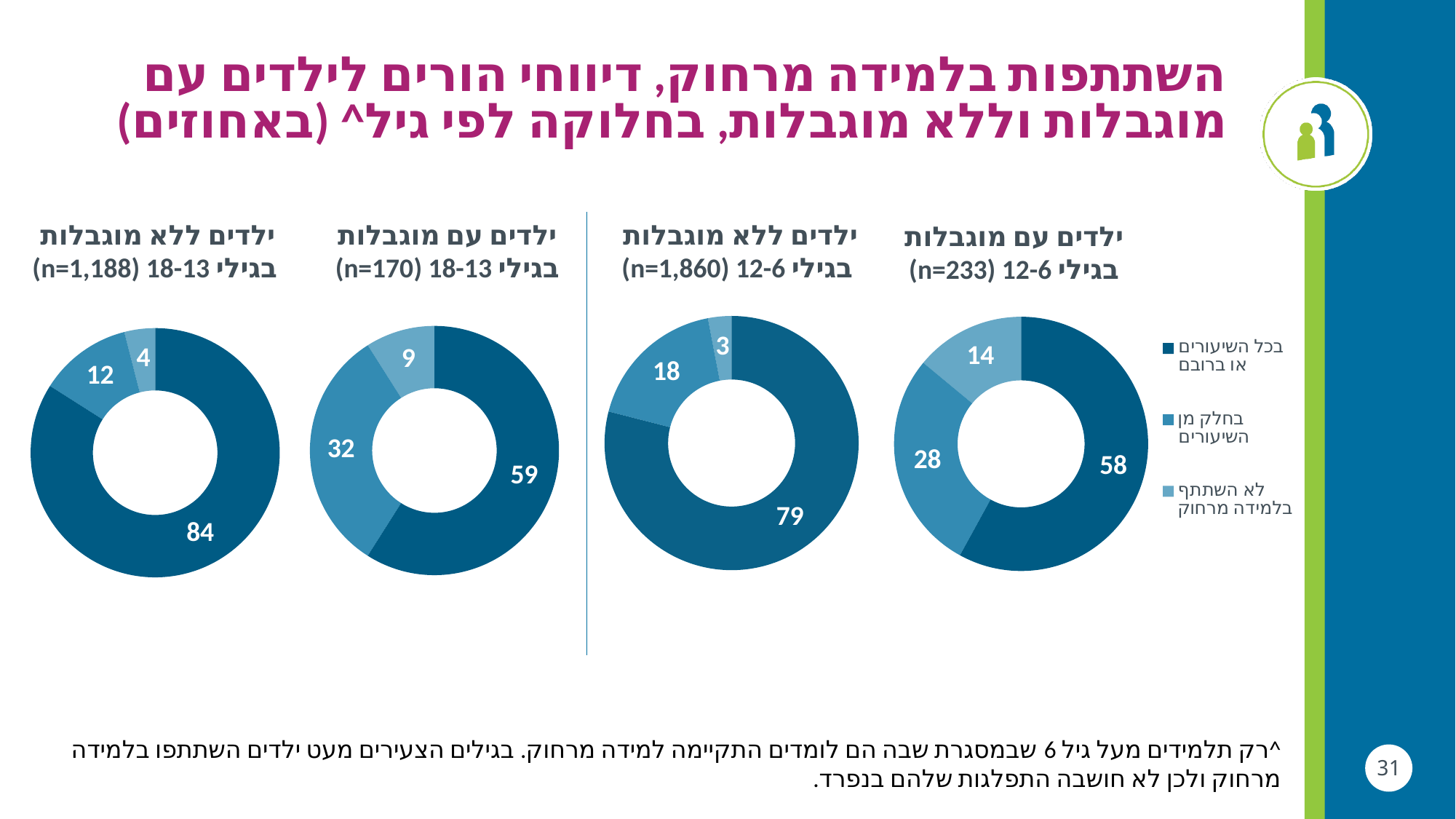
In the chart titled 'ילדים עם מוגבלות בגילי 6-12 (n=233)', what is the value for 'בכל השיעורים או ברובם'? 58 What kind of chart is used on this slide? Donut chart In the chart titled 'ילדים עם מוגבלות בגילי 6-12 (n=233)', which category has the smallest value? לא השתתף בלמידה מרחוק In the chart titled 'ילדים ללא מוגבלות בגילי 13-18 (n=1,188)', which category has the largest value? בכל השיעורים או ברובם In the chart titled 'ילדים עם מוגבלות בגילי 13-18 (n=170)', what is the value for 'בחלק מן השיעורים'? 32 Which is larger: the value for 'בחלק מן השיעורים' in the chart 'ילדים עם מוגבלות בגילי 6-12 (n=233)' or in the chart 'ילדים ללא מוגבלות בגילי 6-12 (n=1,860)'? ילדים עם מוגבלות בגילי 6-12 (n=233) In the chart titled 'ילדים ללא מוגבלות בגילי 6-12 (n=1,860)', what is the difference between 'בכל השיעורים או ברובם' and 'בחלק מן השיעורים'? 61 How many charts are shown on the slide? 4 In the chart titled 'ילדים עם מוגבלות בגילי 13-18 (n=170)', what is the difference between 'בכל השיעורים או ברובם' and 'בחלק מן השיעורים'? 27 In the chart titled 'ילדים ללא מוגבלות בגילי 6-12 (n=1,860)', what is the value for 'לא השתתף בלמידה מרחוק'? 3 How many categories does the legend list? 3 In the chart titled 'ילדים ללא מוגבלות בגילי 13-18 (n=1,188)', what is the value for 'בכל השיעורים או ברובם'? 84